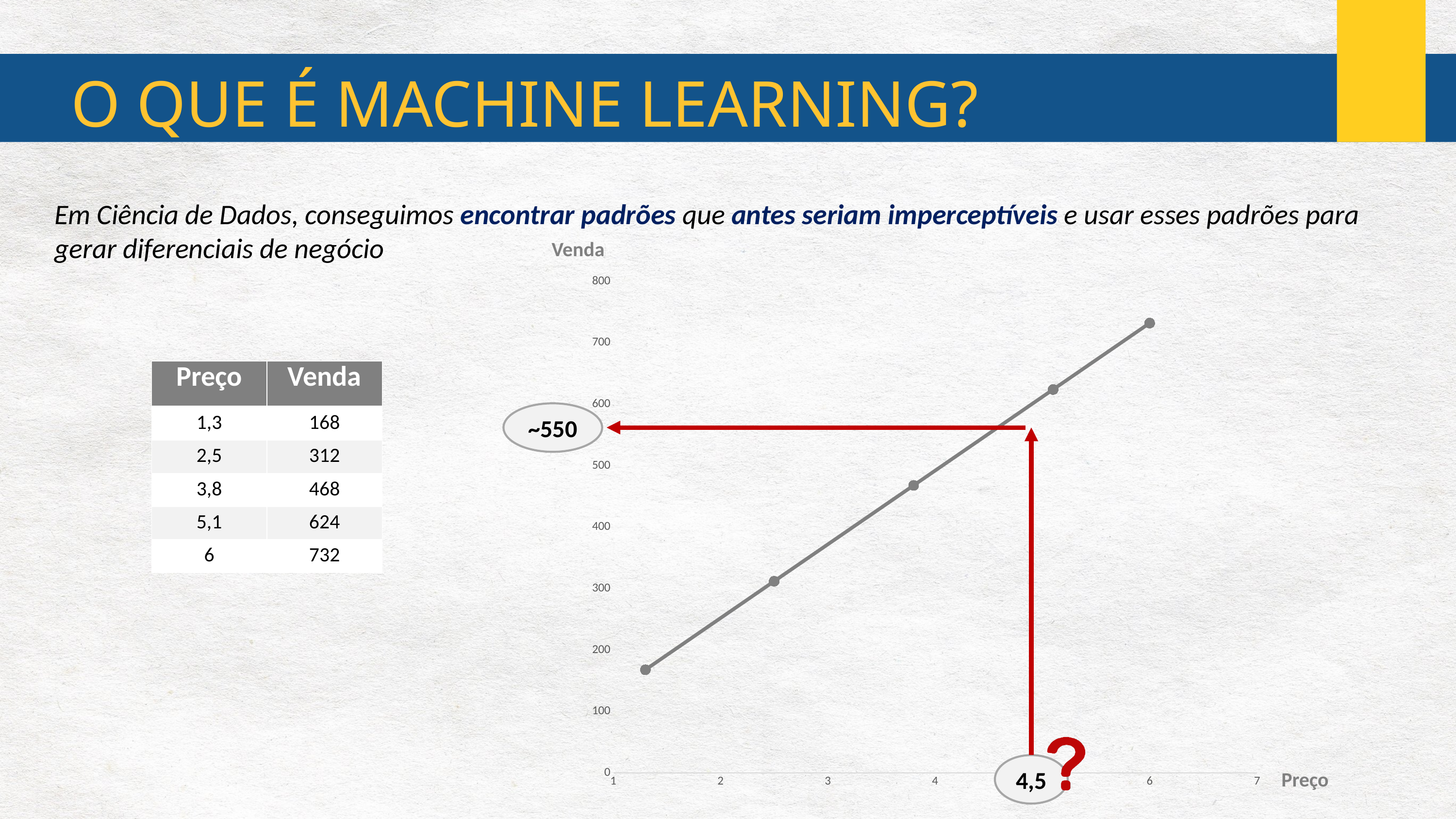
What label does the annotation on the chart show for the estimated Venda at Preço 4,5? ~550 What is the title of the vertical axis of the chart? Venda What is the Venda value for Preço 3,8? 468 How many data points are plotted on the chart? 5 Which has a larger Venda value, Preço 5,1 or Preço 2,5? 5,1 What is the difference between the Venda value at Preço 6 and at Preço 1,3? 564 Which Preço has the highest Venda value? 6 Which Preço has the lowest Venda value? 1,3 What kind of chart is shown on the slide? line chart What is the Venda value for Preço 1,3? 168 Is the Venda value for Preço 6 greater or less than 700? greater Do the Venda values rise or fall as Preço increases along the x axis? rise